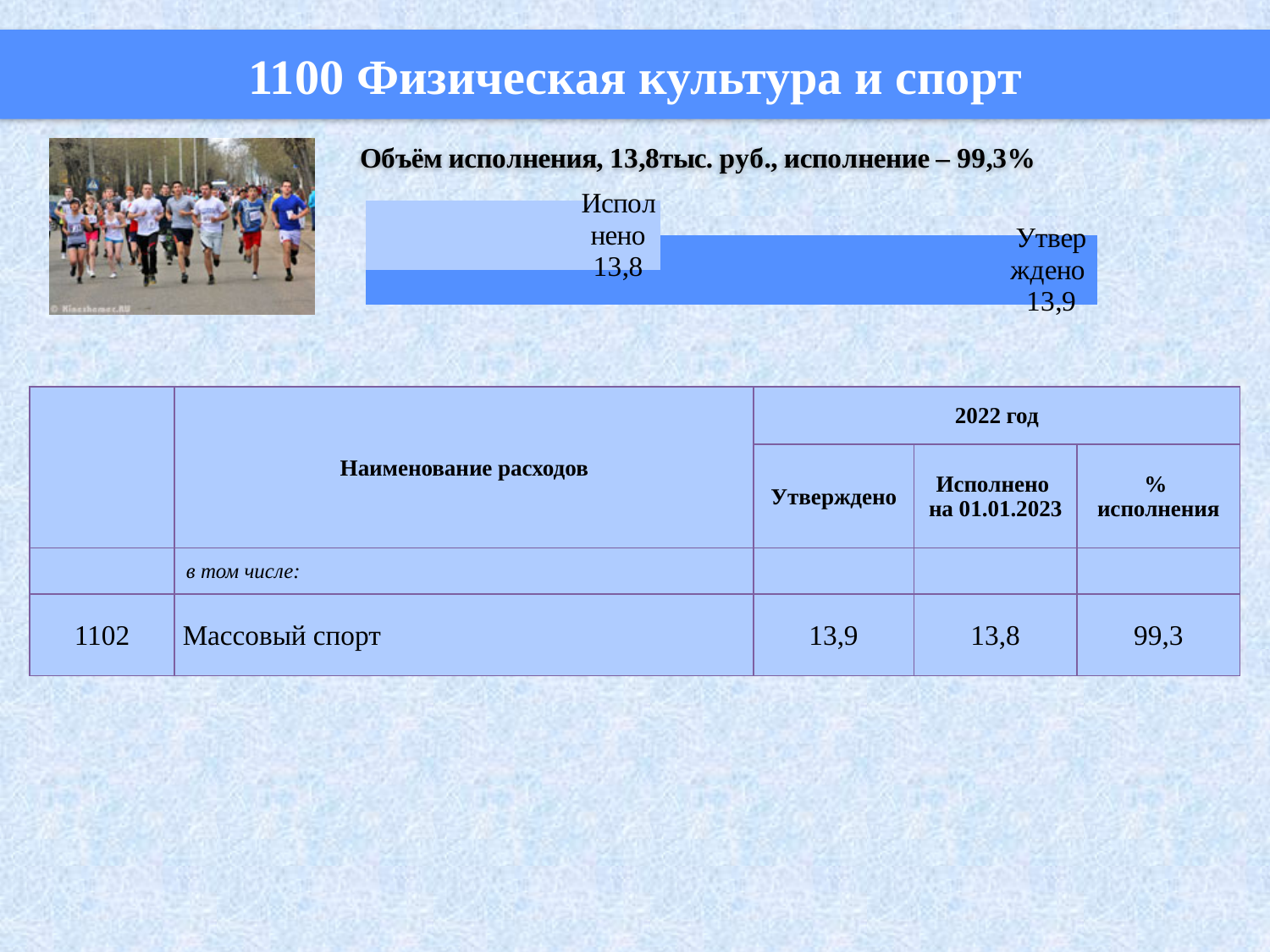
What is the difference between the Утверждено and Исполнено values in the chart? 0,1 Which bar in the chart is drawn in the darker blue colour? Утверждено How many bars are plotted in the chart? 2 What value is shown for Утверждено in the chart? 13,9 What value is shown for Исполнено in the chart? 13,8 Which bar in the chart has the higher value, Исполнено or Утверждено? Утверждено Which category has the lowest value in the chart? Исполнено Which category has the highest value in the chart? Утверждено Which bar in the chart is drawn in the lighter blue colour? Исполнено What type of chart is shown on the slide? Bar chart